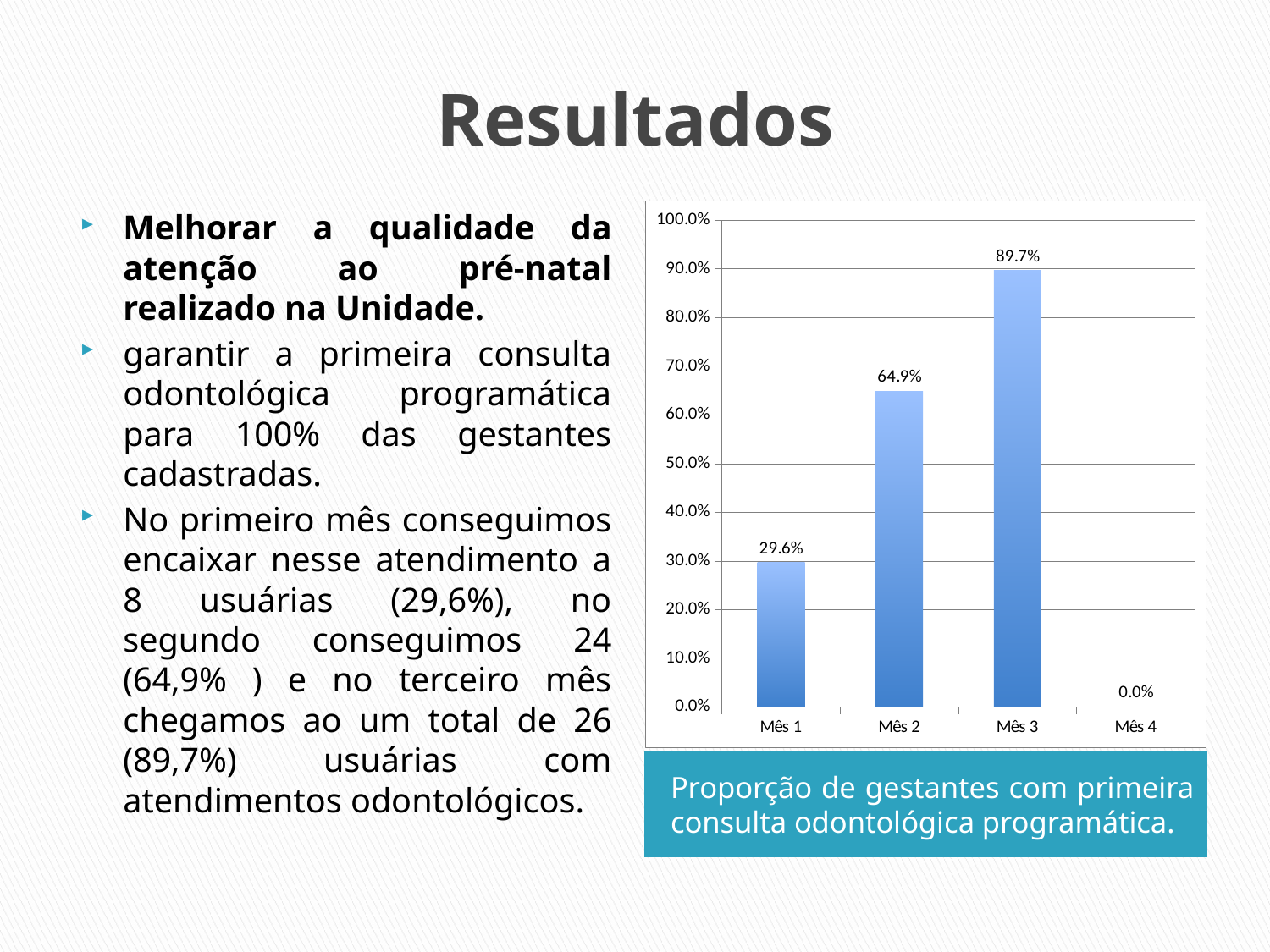
Which month has the lowest value in the chart? Mês 4 What is the difference between the values for Mês 3 and Mês 2? 24.8% How many categories are shown on the x axis of the chart? 4 What is the value for Mês 1 in the chart? 29.6% What is the difference between the values for Mês 2 and Mês 1? 35.3% What is the value for Mês 4 in the chart? 0.0% What is the caption below the chart? Proporção de gestantes com primeira consulta odontológica programática. Which month has the highest value in the chart? Mês 3 What is the value for Mês 3 in the chart? 89.7% What is the value for Mês 2 in the chart? 64.9% What kind of chart is shown on the slide? Bar chart Which is larger, the value for Mês 1 or the value for Mês 2? Mês 2